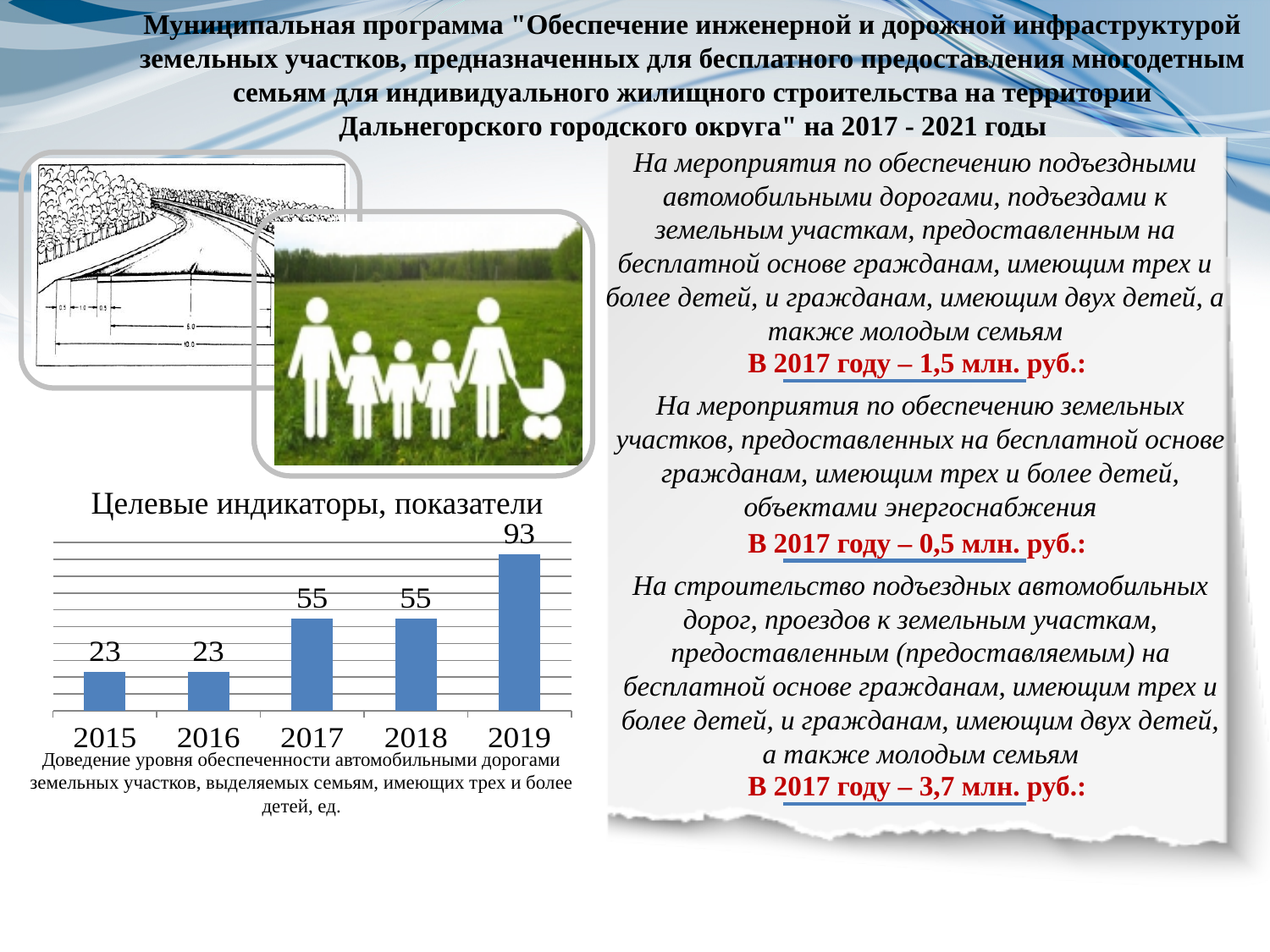
Which year has the highest value in the chart "Целевые индикаторы, показатели"? 2019 What is the value for 2018 in the chart "Целевые индикаторы, показатели"? 55 Which is larger in the chart "Целевые индикаторы, показатели": the value for 2016 or the value for 2017? 2017 What is the difference between the values for 2019 and 2018 in the chart "Целевые индикаторы, показатели"? 38 What is the value for 2015 in the chart "Целевые индикаторы, показатели"? 23 What is the difference between the values for 2017 and 2016 in the chart "Целевые индикаторы, показатели"? 32 What is the value for 2019 in the chart "Целевые индикаторы, показатели"? 93 What is the value for 2017 in the chart "Целевые индикаторы, показатели"? 55 What is the lowest value shown in the chart "Целевые индикаторы, показатели"? 23 What kind of chart is "Целевые индикаторы, показатели"? Bar chart Do the values in the chart "Целевые индикаторы, показатели" generally rise or fall from 2015 to 2019? Rise How many years are shown on the x axis of the chart "Целевые индикаторы, показатели"? 5